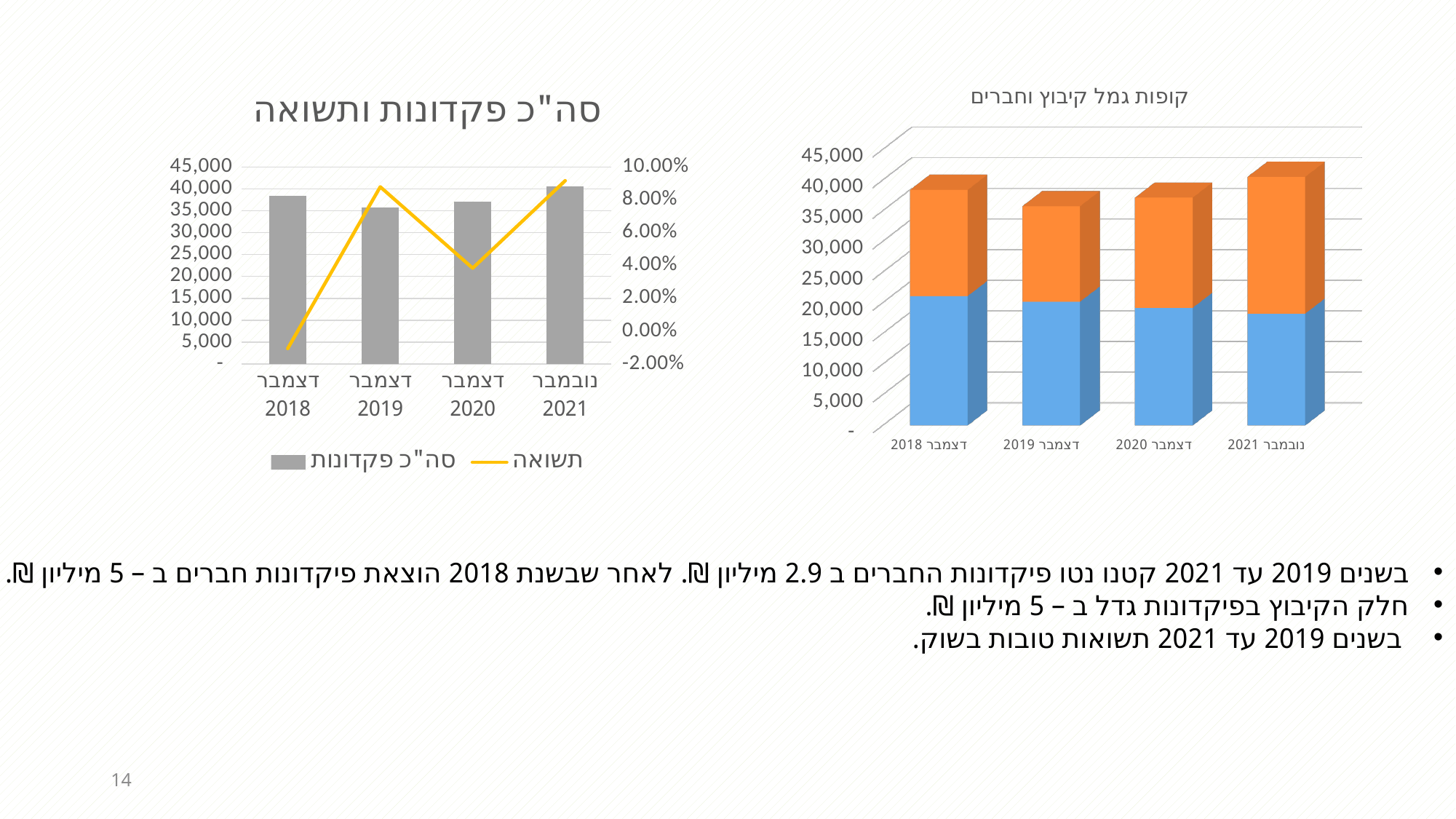
In the chart titled "סה"כ פקדונות ותשואה", which category has the lowest bar for סה"כ פקדונות? דצמבר 2019 What kind of chart is the chart titled "סה"כ פקדונות ותשואה" on the left? A combined bar and line chart In the chart titled "סה"כ פקדונות ותשואה", how many categories are shown on the x axis? 4 In the chart titled "קופות גמל קיבוץ וחברים", does the blue segment rise or fall from דצמבר 2018 to נובמבר 2021? fall In the chart titled "סה"כ פקדונות ותשואה", is the סה"כ פקדונות value for דצמבר 2018 greater or less than 35,000? greater What kind of chart is the chart titled "קופות גמל קיבוץ וחברים" on the right? A stacked bar chart In the chart titled "קופות גמל קיבוץ וחברים", is the blue segment for דצמבר 2018 greater or less than 20,000? greater In the chart titled "סה"כ פקדונות ותשואה", how many series does the legend list? 2 In the chart titled "סה"כ פקדונות ותשואה", which category has the lowest value on the תשואה line? דצמבר 2018 In the chart titled "סה"כ פקדונות ותשואה", which category has the highest bar for סה"כ פקדונות? נובמבר 2021 In the chart titled "סה"כ פקדונות ותשואה", is the תשואה value for דצמבר 2018 greater or less than 0.00%? less In the chart titled "סה"כ פקדונות ותשואה", which is larger, the סה"כ פקדונות bar for דצמבר 2018 or for דצמבר 2019? דצמבר 2018